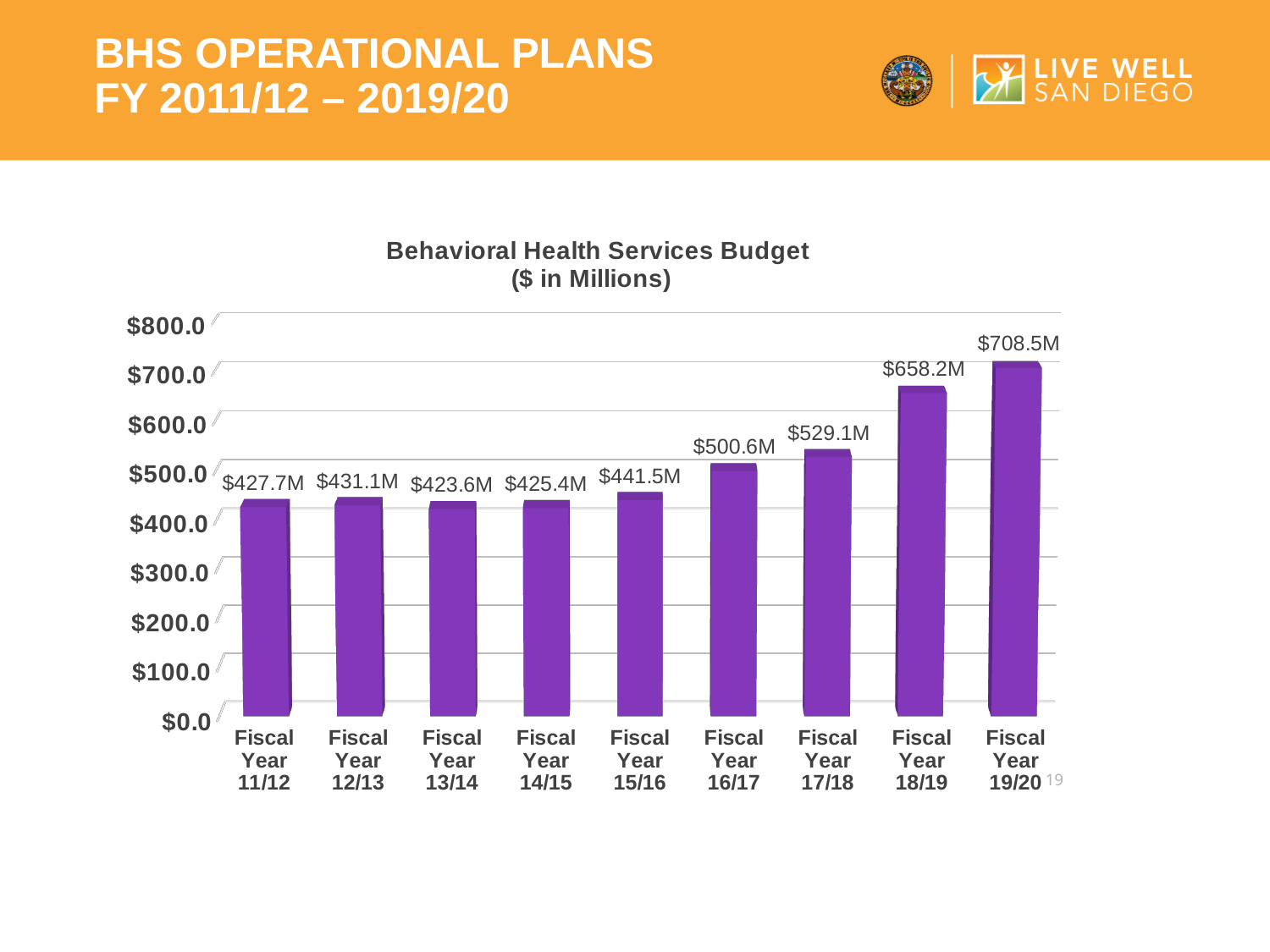
What is the Behavioral Health Services budget for Fiscal Year 16/17? $500.6M Which is larger, the budget for Fiscal Year 17/18 or Fiscal Year 15/16? Fiscal Year 17/18 What kind of chart is shown on the slide? Bar chart What is the title of the chart? Behavioral Health Services Budget ($ in Millions) Which fiscal year has the highest Behavioral Health Services budget? Fiscal Year 19/20 What is the difference between the budgets for Fiscal Year 19/20 and Fiscal Year 18/19? $50.3M Which fiscal year has the lowest Behavioral Health Services budget? Fiscal Year 13/14 What is the Behavioral Health Services budget for Fiscal Year 11/12? $427.7M Do the budget values generally rise or fall from Fiscal Year 15/16 to Fiscal Year 19/20? Rise How many fiscal years are shown in the chart? 9 Is the budget for Fiscal Year 19/20 greater or less than $700.0? greater What is the Behavioral Health Services budget for Fiscal Year 18/19? $658.2M